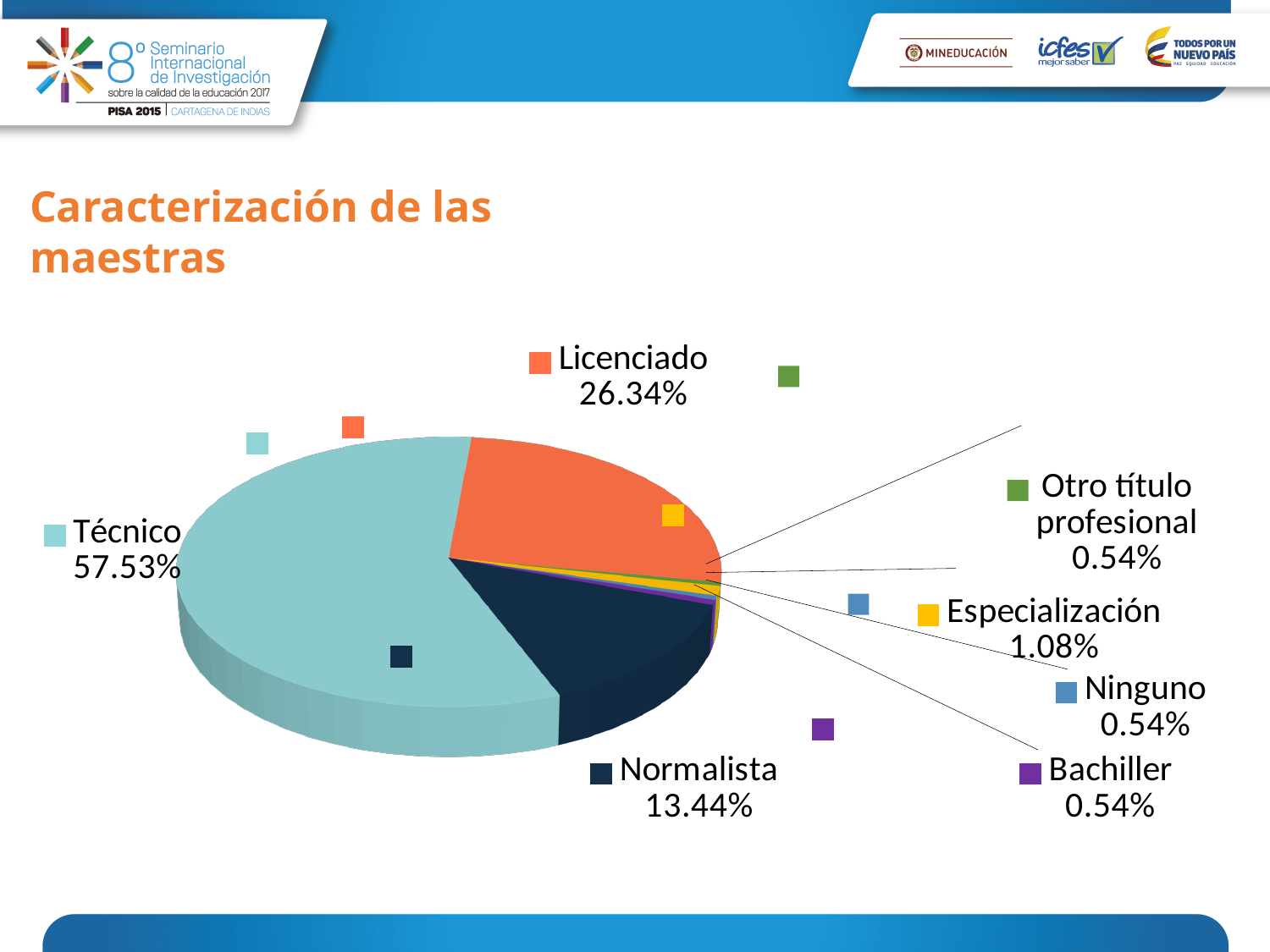
What share of the pie does Técnico represent? 57.53% How many categories are shown in the pie chart? 7 Which category has the largest slice of the pie? Técnico What is the difference in percentage points between Licenciado and Normalista? 12.90 Which is larger, the share for Licenciado or the share for Normalista? Licenciado What is the difference in percentage points between Técnico and Licenciado? 31.19 What is the value shown for Licenciado? 26.34% What percentage is shown for Normalista? 13.44% What is the value shown for Especialización? 1.08% What percentage is shown for Bachiller? 0.54% What is the title of the slide containing the pie chart? Caracterización de las maestras What kind of chart is shown on the slide? Pie chart